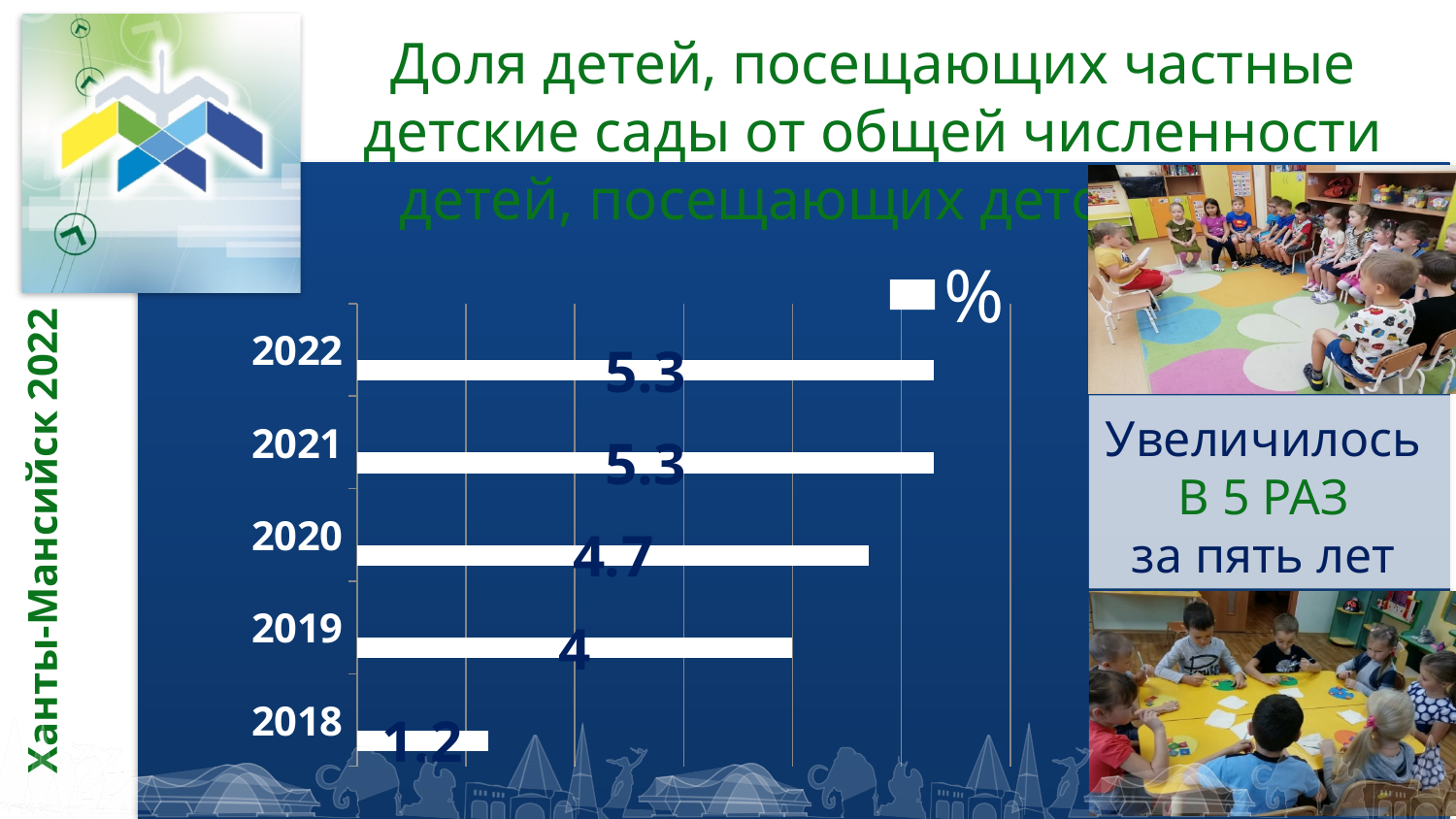
How many years are shown on the chart? 5 What is the value for 2019? 4 What is the value for 2022? 5.3 What is the legend entry for the series? % What is the difference between the values for 2020 and 2019? 0.7 How many series does the legend list? 1 What type of chart is shown on the slide? bar chart Which year has the lowest value? 2018 What is the value for 2018? 1.2 Which is larger, the value for 2020 or the value for 2019? 2020 What is the difference between the values for 2022 and 2018? 4.1 What is the value for 2020? 4.7